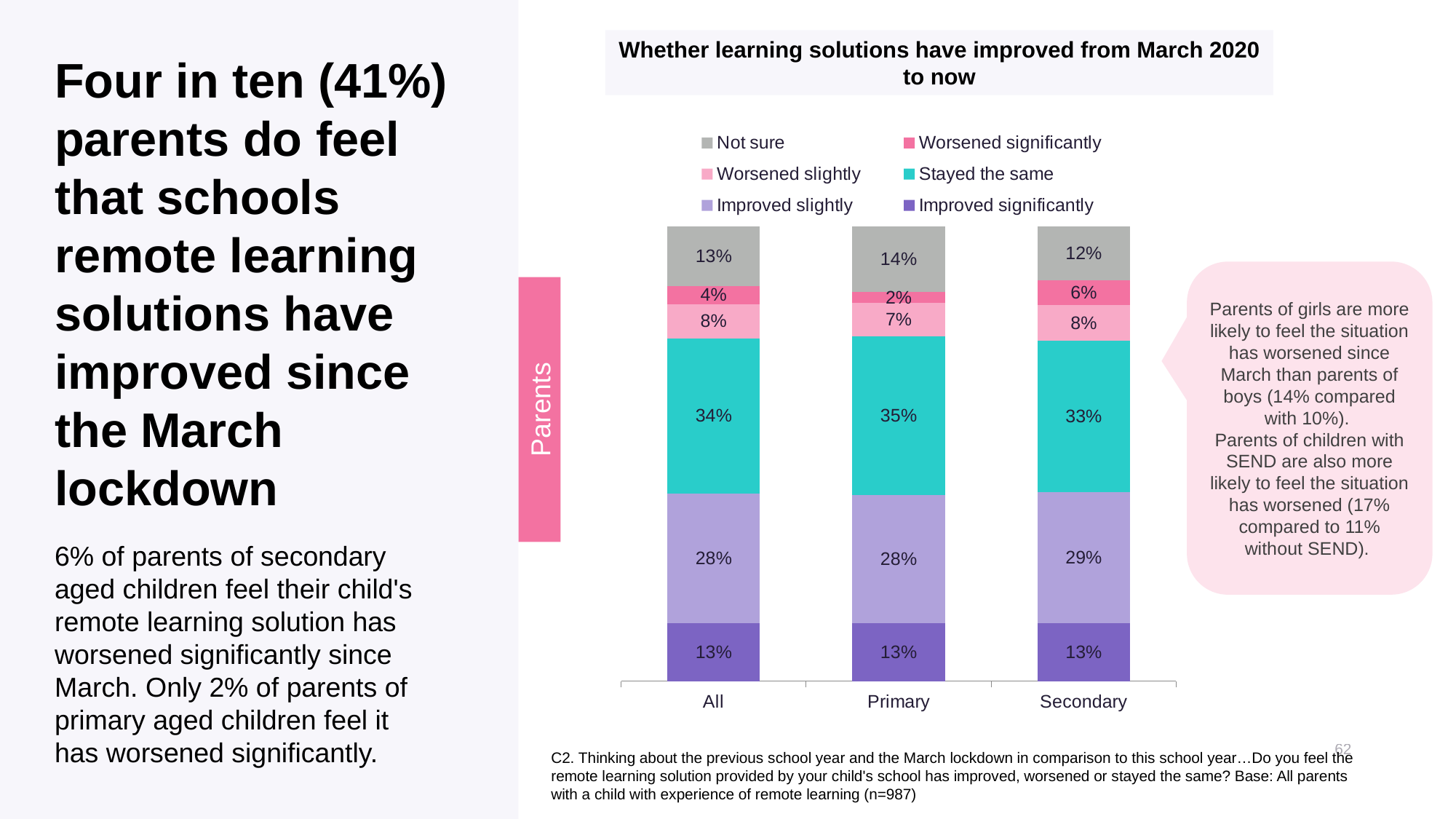
How many series does the chart legend list? 6 Which category has the lowest share of parents saying the solution worsened significantly? Primary Is the 'Stayed the same' share larger for Primary or Secondary? Primary What percentage of parents of primary aged children said the solution improved slightly? 28% What is the title of the chart? Whether learning solutions have improved from March 2020 to now What type of chart is shown on the slide? Stacked bar chart What percentage of all parents said the remote learning solution stayed the same? 34% Which category has the highest share of parents saying the solution worsened significantly? Secondary What percentage of parents of secondary aged children said the solution worsened significantly? 6% How many categories are shown on the x axis of the chart? 3 What percentage of parents of primary aged children were not sure? 14% What is the difference between the Secondary and Primary percentages for 'Worsened significantly'? 4 percentage points